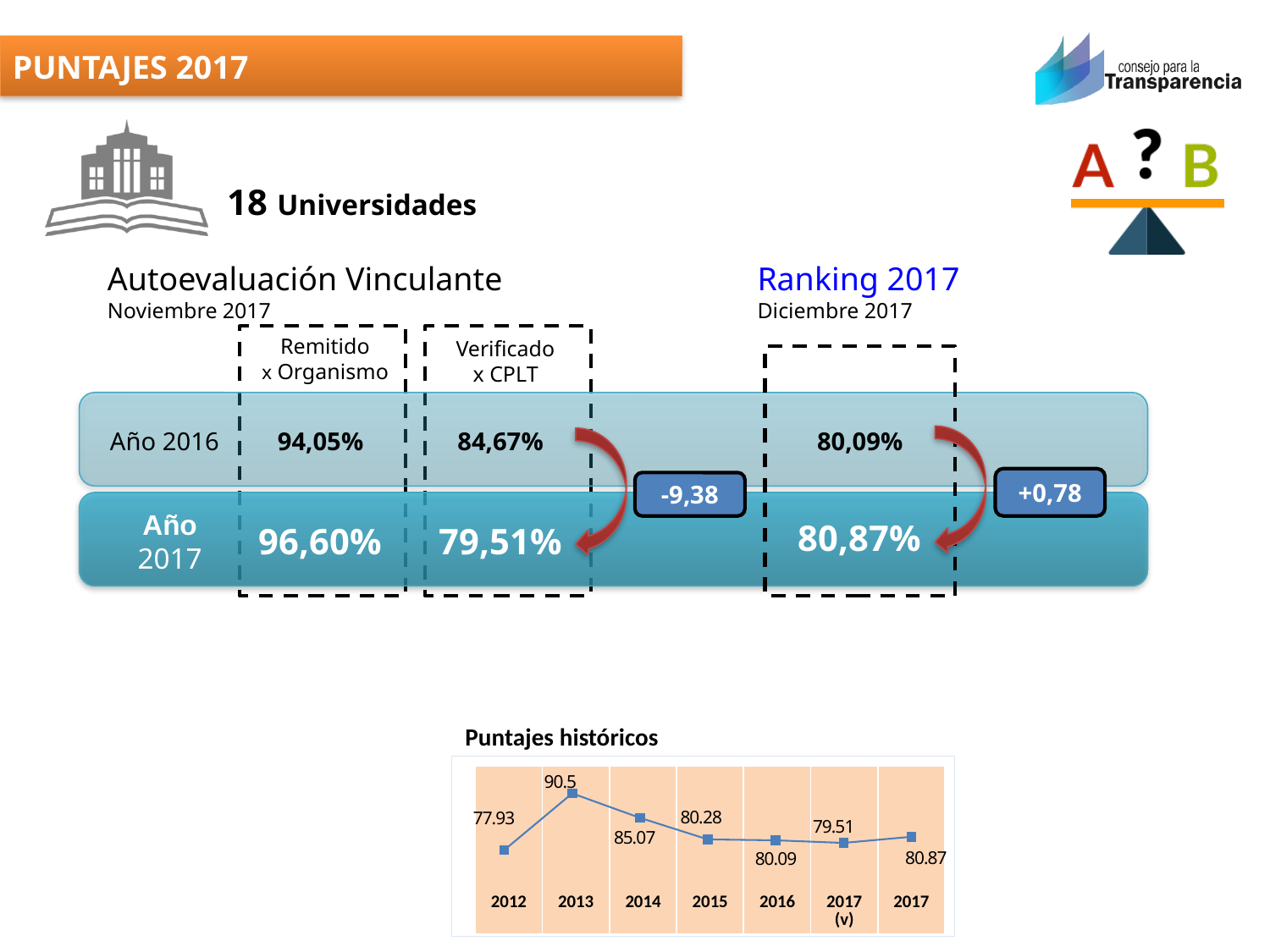
In the 'Puntajes históricos' chart, which year has the lowest value? 2012 In the 'Puntajes históricos' chart, what is the difference between the values for 2017 and 2017 (v)? 1.36 In the 'Puntajes históricos' chart, what is the value for 2017 (v)? 79.51 In the 'Puntajes históricos' chart, what is the value for 2012? 77.93 How many data points are plotted in the 'Puntajes históricos' chart? 7 In the 'Puntajes históricos' chart, which is larger, the value for 2014 or the value for 2016? 2014 In the 'Puntajes históricos' chart, what is the difference between the values for 2013 and 2014? 5.43 In the 'Puntajes históricos' chart, which year has the highest value? 2013 In the 'Puntajes históricos' chart, what is the value for 2013? 90.5 In the 'Puntajes históricos' chart, do the values rise or fall from 2013 to 2016? Fall In the 'Puntajes históricos' chart, what is the value for 2015? 80.28 What kind of chart is 'Puntajes históricos'? Line chart